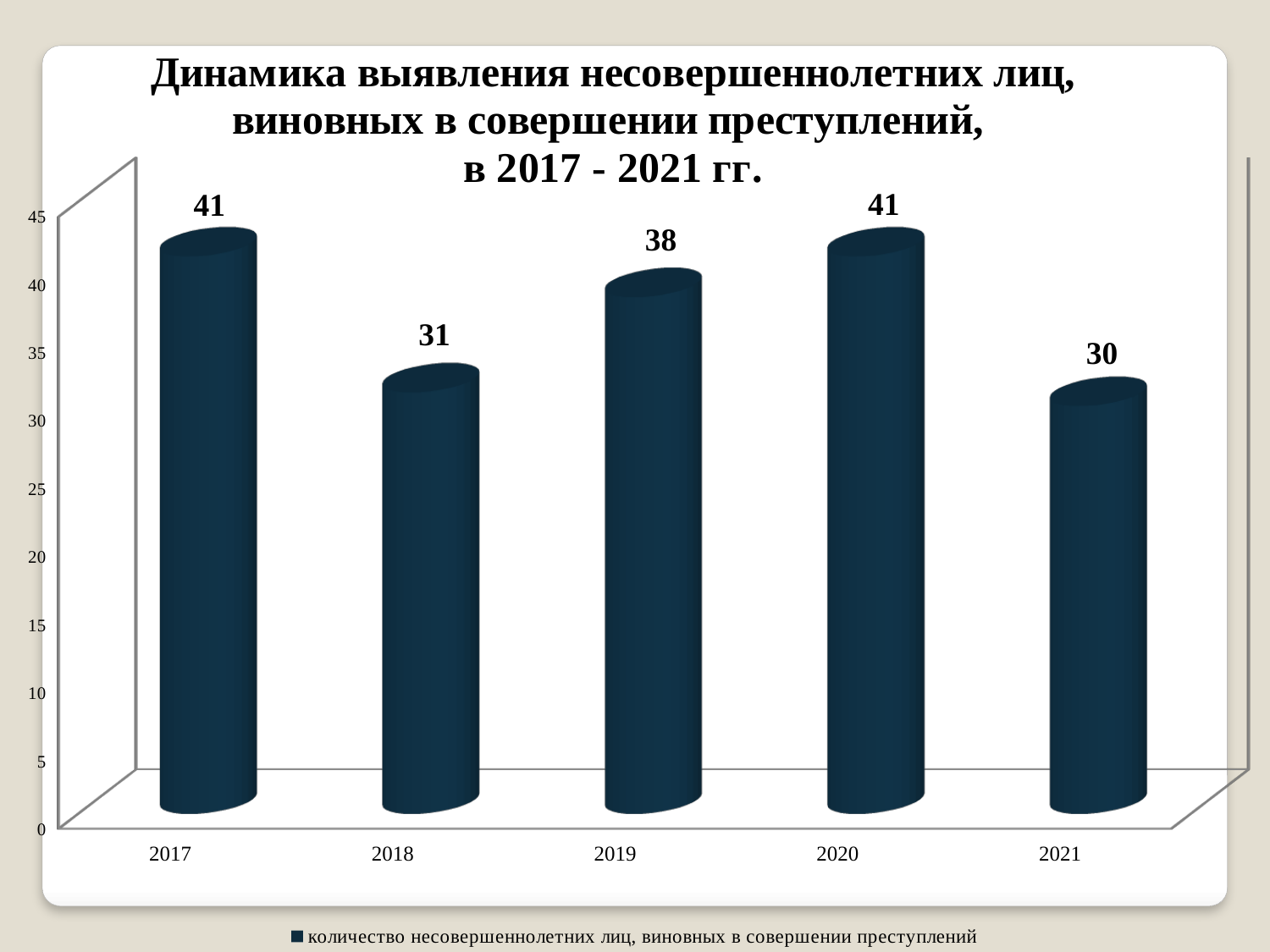
What is the difference between the values for 2017 and 2018? 10 What is the value for 2019? 38 What is the value for 2021? 30 What is the value for 2018? 31 Which is larger, the value for 2019 or the value for 2020? 2020 What kind of chart is shown on the slide? bar chart Which year has the lowest value? 2021 Is the value for 2018 greater or less than 35? less How many years are shown on the x axis? 5 What is the value for 2017? 41 What is the difference between the values for 2019 and 2021? 8 How many series does the legend list? 1